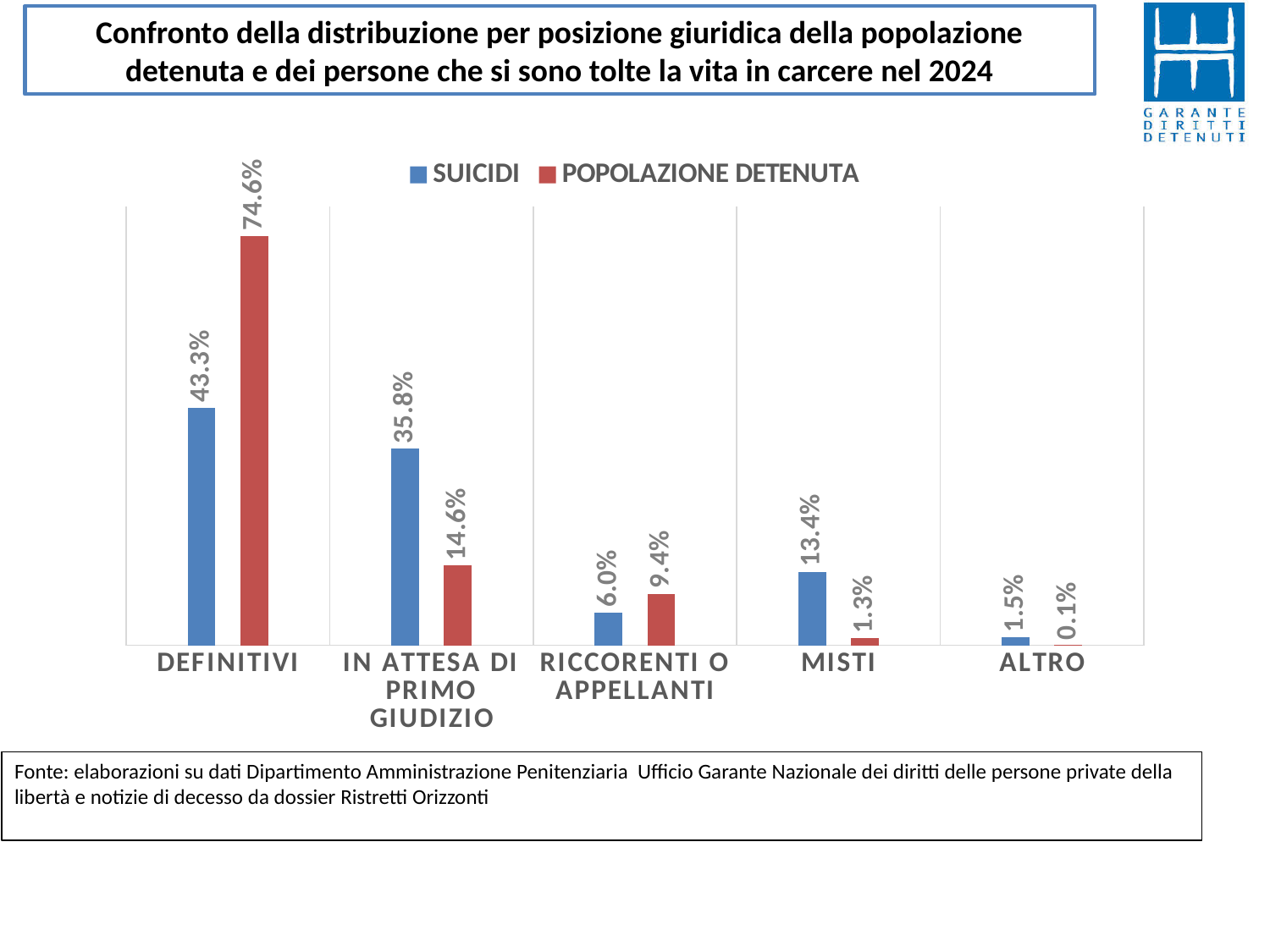
How many categories are shown on the x axis? 5 What is the POPOLAZIONE DETENUTA value for DEFINITIVI? 74.6% Which category has the highest POPOLAZIONE DETENUTA value? DEFINITIVI What is the POPOLAZIONE DETENUTA value for MISTI? 1.3% Which colour represents the SUICIDI series? Blue What is the SUICIDI value for DEFINITIVI? 43.3% For MISTI, which series has the larger value, SUICIDI or POPOLAZIONE DETENUTA? SUICIDI What is the difference between the POPOLAZIONE DETENUTA and SUICIDI values for DEFINITIVI? 31.3% What kind of chart is shown on the slide? Bar chart How many series does the legend list? 2 What is the SUICIDI value for IN ATTESA DI PRIMO GIUDIZIO? 35.8% Which category has the lowest SUICIDI value? ALTRO